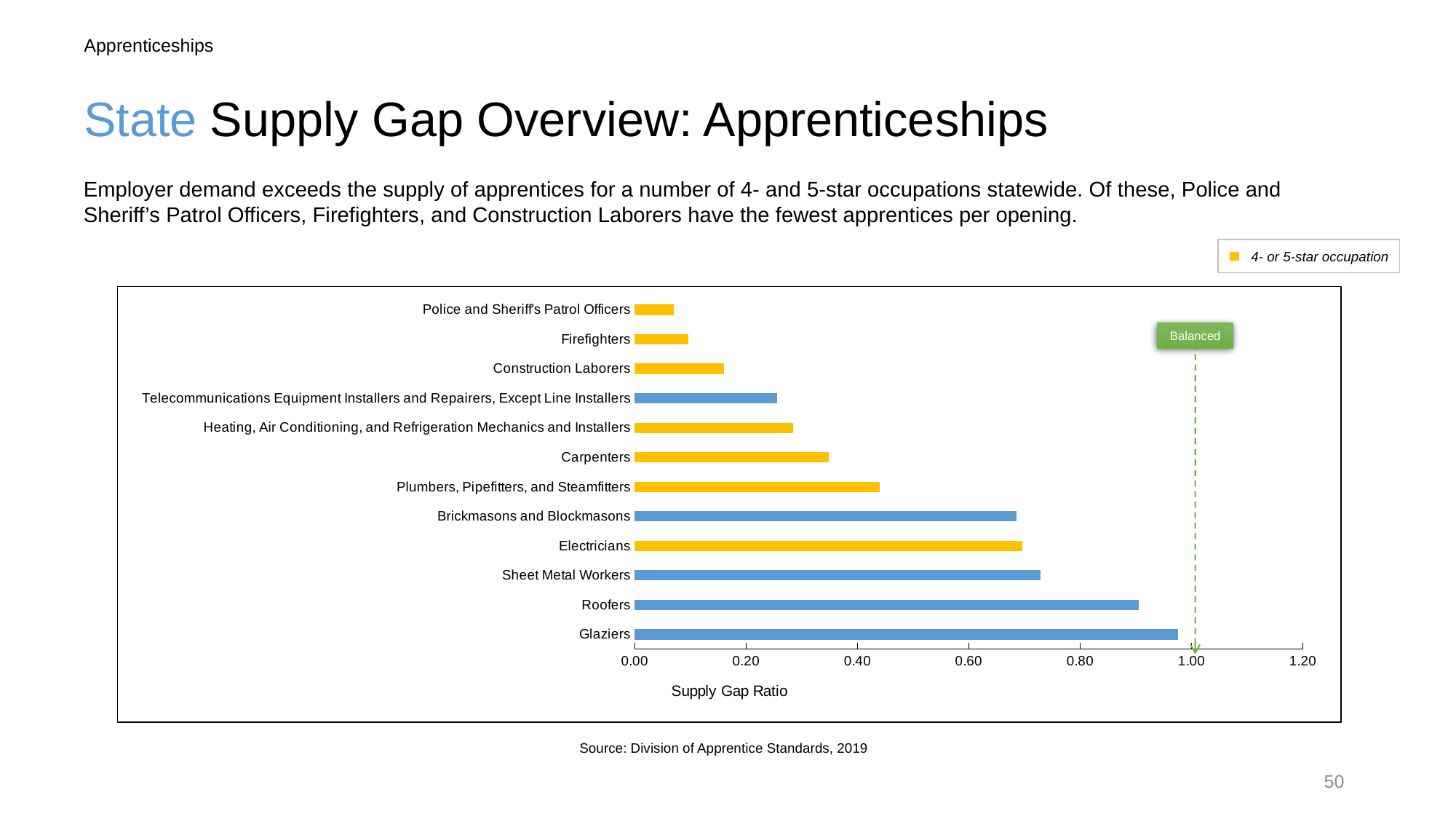
Which has a larger supply gap ratio, Plumbers, Pipefitters, and Steamfitters or Firefighters? Plumbers, Pipefitters, and Steamfitters Which occupation has the lowest supply gap ratio? Police and Sheriff's Patrol Officers Is the supply gap ratio for Roofers greater or less than 0.80? greater What kind of chart is shown on the slide? bar chart How many occupations are plotted in the chart? 12 Which has a larger supply gap ratio, Roofers or Carpenters? Roofers Is the supply gap ratio for Carpenters greater or less than 0.40? less What is the title of the x axis? Supply Gap Ratio At what x-axis value is the dashed 'Balanced' line drawn? 1.00 Is the supply gap ratio for Construction Laborers greater or less than 0.20? less Which occupation has the highest supply gap ratio? Glaziers